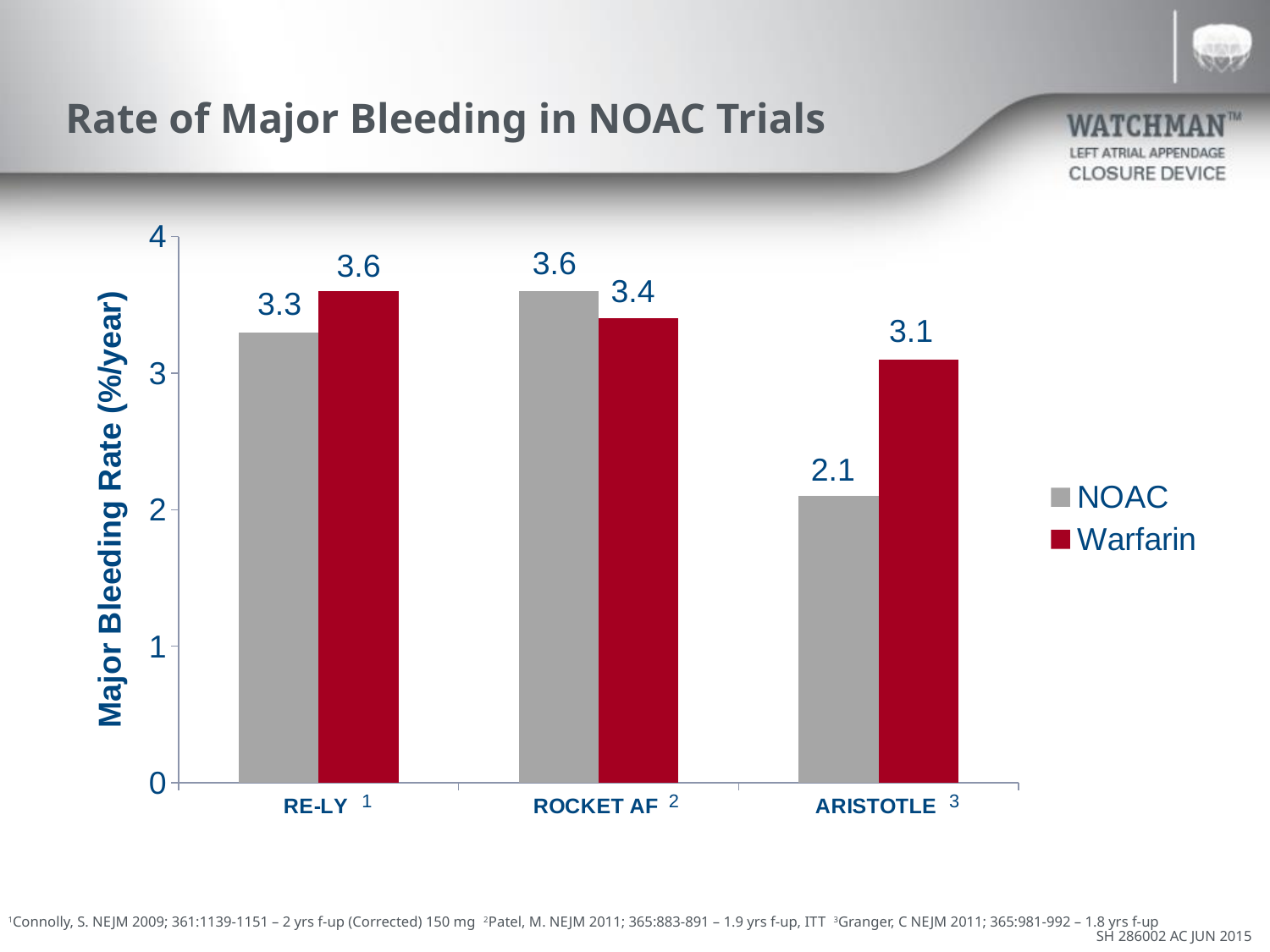
Which trial has the highest Warfarin major bleeding rate? RE-LY What type of chart is shown on the slide? bar chart How many series does the chart legend list? 2 What is the major bleeding rate for NOAC in the RE-LY trial? 3.3 In the ROCKET AF trial, which has the higher major bleeding rate, NOAC or Warfarin? NOAC What is the difference between the Warfarin and NOAC major bleeding rates in the ARISTOTLE trial? 1.0 What is the label of the y axis of the chart? Major Bleeding Rate (%/year) What is the major bleeding rate for NOAC in the ROCKET AF trial? 3.6 How many trials are shown on the x axis of the chart? 3 Is the NOAC major bleeding rate in the ARISTOTLE trial greater or less than 3? less What is the major bleeding rate for Warfarin in the ARISTOTLE trial? 3.1 Which trial has the lowest NOAC major bleeding rate? ARISTOTLE